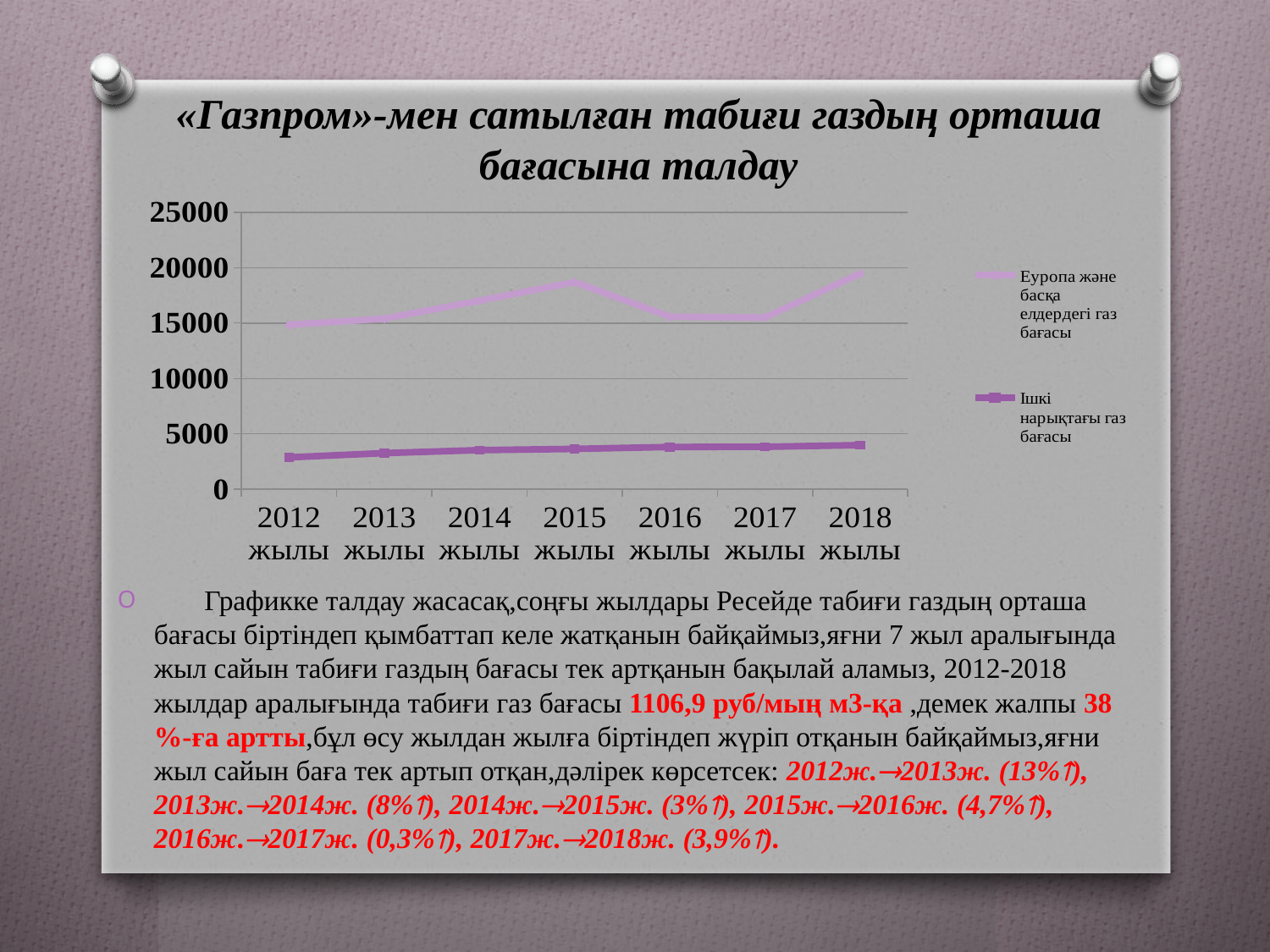
How many series does the legend list? 2 In which year is the value for Ішкі нарықтағы газ бағасы the lowest? 2012 жылы In 2012 жылы, which series has the larger value: Еуропа және басқа елдердегі газ бағасы or Ішкі нарықтағы газ бағасы? Еуропа және басқа елдердегі газ бағасы Which series is plotted in the darker purple line? Ішкі нарықтағы газ бағасы Does the value for Ішкі нарықтағы газ бағасы rise or fall from 2012 жылы to 2018 жылы? rise What kind of chart is shown on the slide? line chart What is the title of the chart on the slide? «Газпром»-мен сатылған табиғи газдың орташа бағасына талдау How many years are plotted along the x axis? 7 Is the value for Ішкі нарықтағы газ бағасы in 2012 жылы greater or less than 5000? less Is the value for Еуропа және басқа елдердегі газ бағасы in 2015 жылы greater or less than 15000? greater In which year is the value for Ішкі нарықтағы газ бағасы the highest? 2018 жылы